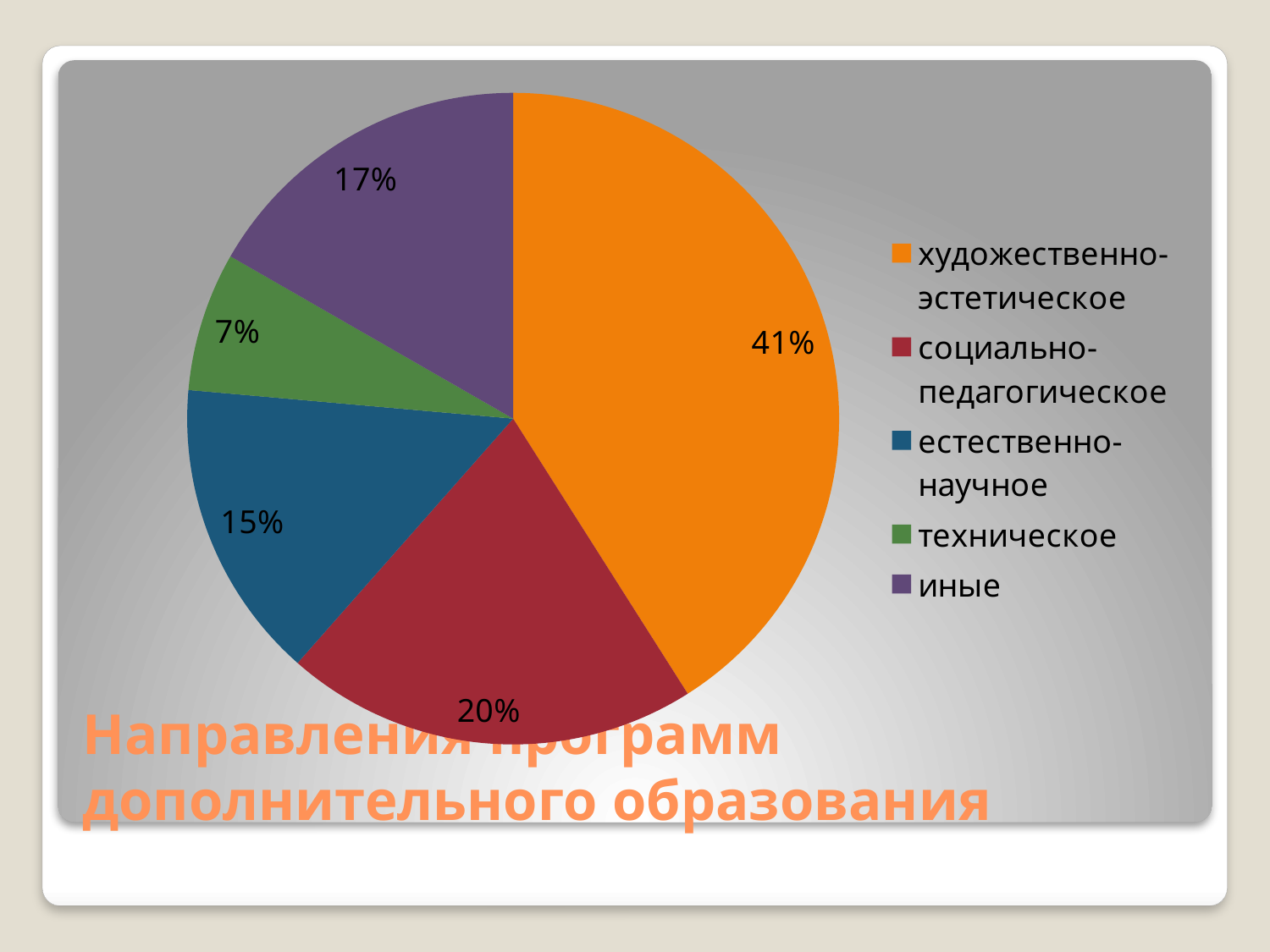
Which category has the smallest slice? техническое What colour is the slice for техническое? green What is the value for техническое? 7% What is the value for иные? 17% What is the value for социально-педагогическое? 20% How many categories does the pie chart show? 5 Which category has the largest slice? художественно-эстетическое What share of the pie does художественно-эстетическое have? 41% What is the difference between the shares of художественно-эстетическое and социально-педагогическое? 21% Which is larger, the slice for иные or the slice for естественно-научное? иные What is the value for естественно-научное? 15% What kind of chart is shown on the slide? pie chart